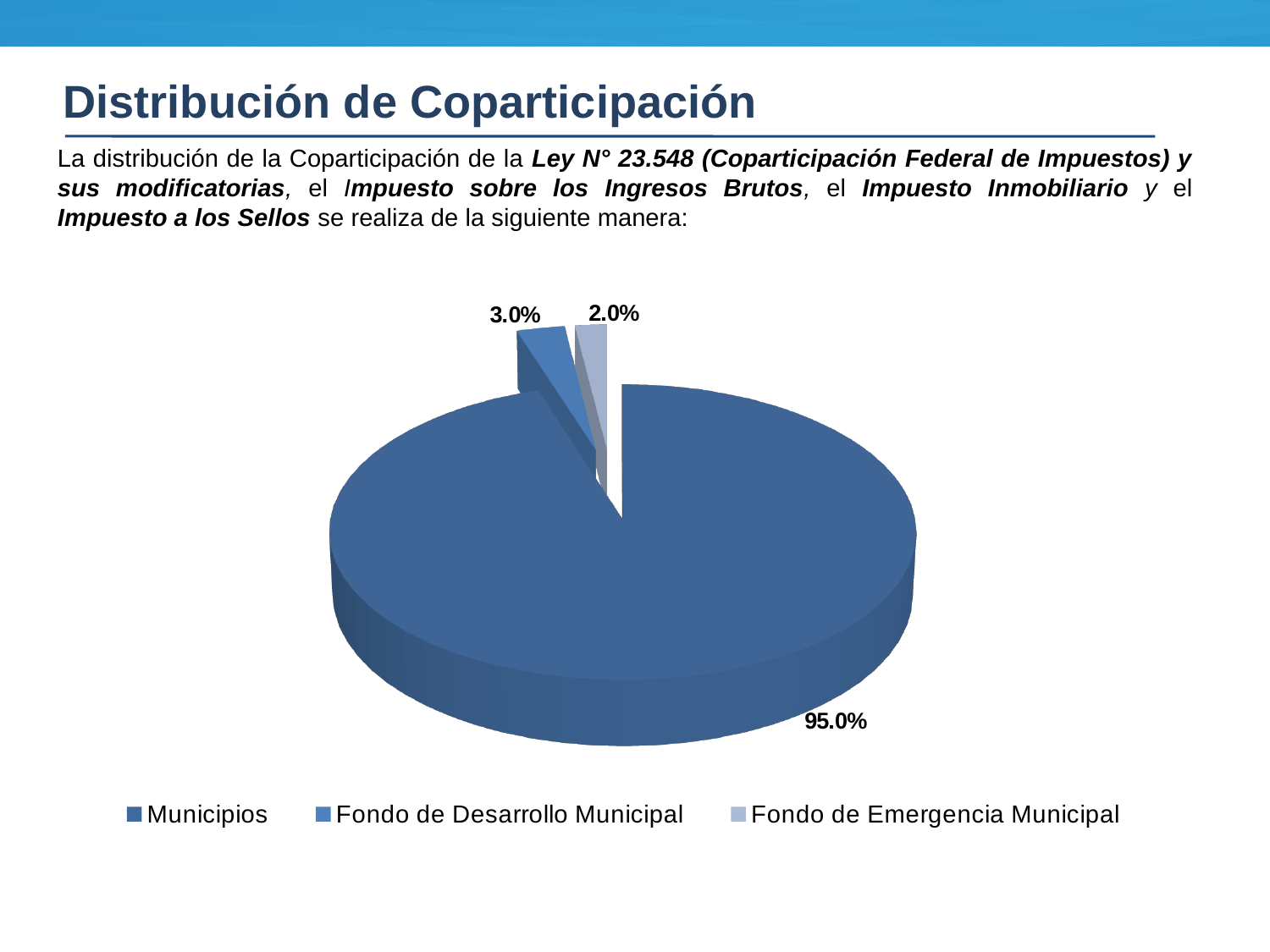
What kind of chart is shown on the slide? pie chart What share of the pie does Fondo de Emergencia Municipal have? 2.0% How many entries does the legend list? 3 What is the difference between the shares of Municipios and Fondo de Desarrollo Municipal? 92.0% Which is larger, the share of Fondo de Desarrollo Municipal or Fondo de Emergencia Municipal? Fondo de Desarrollo Municipal Which category has the smallest slice of the pie? Fondo de Emergencia Municipal What share of the pie does Fondo de Desarrollo Municipal have? 3.0% Which category has the largest slice of the pie? Municipios What is the combined share of Fondo de Desarrollo Municipal and Fondo de Emergencia Municipal? 5.0% What is the difference between the shares of Fondo de Desarrollo Municipal and Fondo de Emergencia Municipal? 1.0% How many slices does the pie chart have? 3 What share of the pie does Municipios have? 95.0%